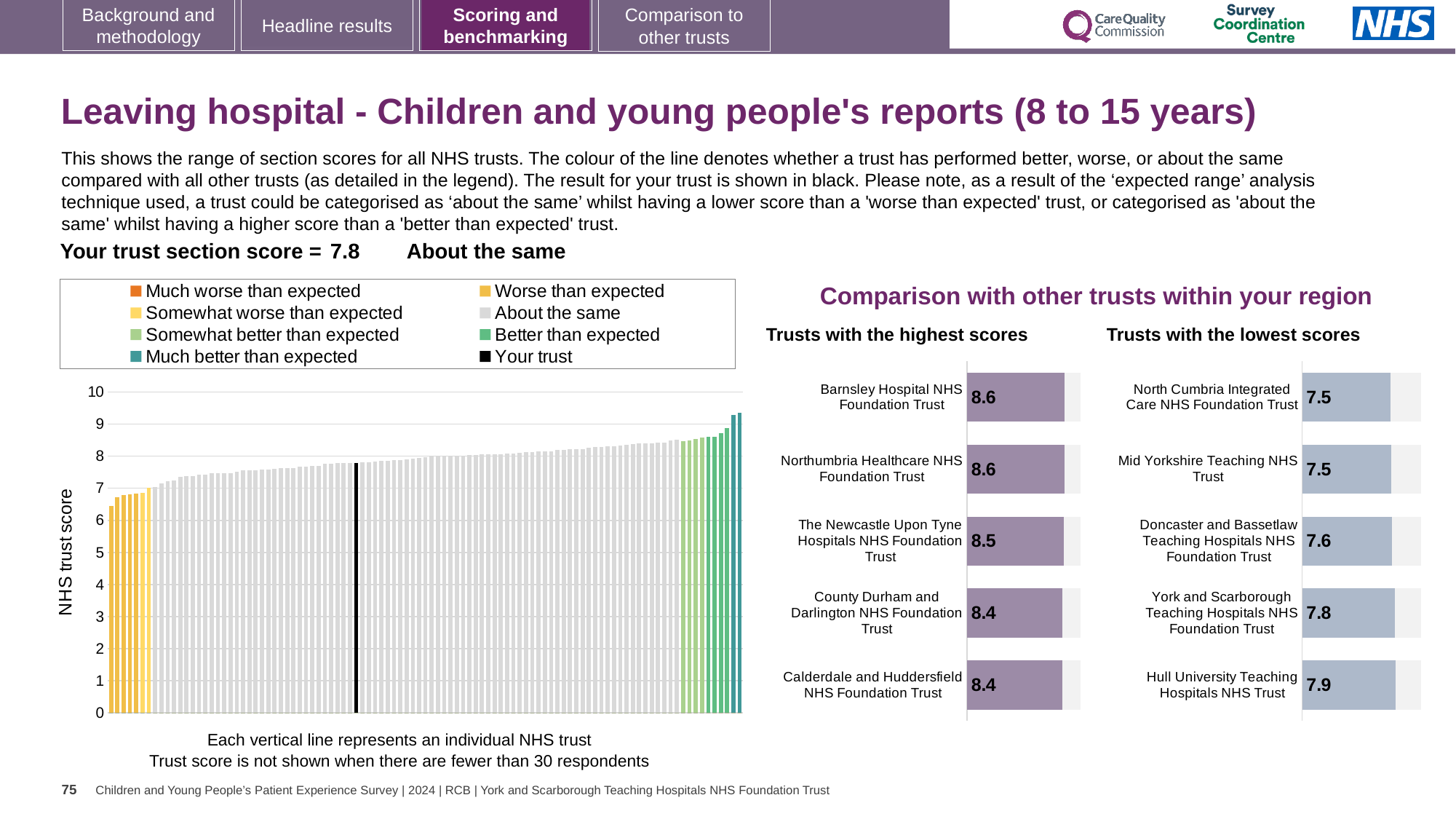
In the 'Trusts with the highest scores' chart, what is the score for The Newcastle Upon Tyne Hospitals NHS Foundation Trust? 8.5 In the large chart on the left, is the value for the black 'Your trust' bar greater or less than 8? less In the large chart on the left, do the trust scores rise or fall from left to right? Rise Which has the larger score: The Newcastle Upon Tyne Hospitals NHS Foundation Trust in the 'highest scores' chart or Doncaster and Bassetlaw Teaching Hospitals NHS Foundation Trust in the 'lowest scores' chart? The Newcastle Upon Tyne Hospitals NHS Foundation Trust How many trusts are listed in the 'Trusts with the lowest scores' chart? 5 What kind of chart is the large chart on the left showing NHS trust scores? Bar chart What is the y-axis label of the large chart on the left? NHS trust score What is the difference between Barnsley Hospital NHS Foundation Trust's score in the 'Trusts with the highest scores' chart and Hull University Teaching Hospitals NHS Trust's score in the 'Trusts with the lowest scores' chart? 0.7 In the 'Trusts with the lowest scores' chart, which trust has the highest score? Hull University Teaching Hospitals NHS Trust In the 'Trusts with the lowest scores' chart, what is the score for York and Scarborough Teaching Hospitals NHS Foundation Trust? 7.8 In the 'Trusts with the highest scores' chart, what is the score for Barnsley Hospital NHS Foundation Trust? 8.6 How many entries does the legend of the large chart on the left list? 8